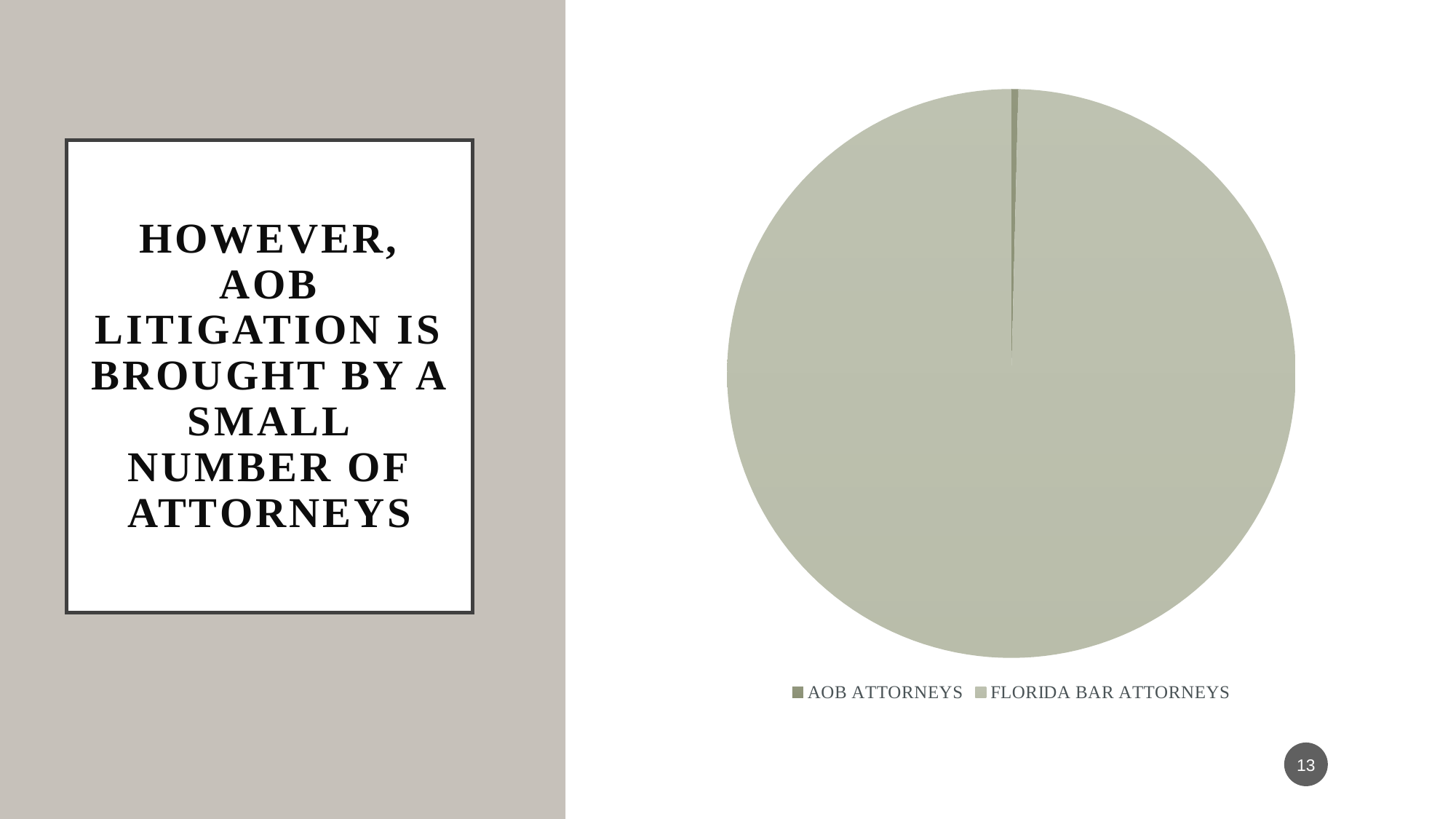
Which category takes up the smallest share of the pie chart? AOB Attorneys What are the two categories listed in the legend of the pie chart? AOB Attorneys and Florida Bar Attorneys How many entries does the legend of the pie chart list? 2 Which category takes up the largest share of the pie chart? Florida Bar Attorneys What kind of chart is shown on the slide? pie chart Which slice is larger in the pie chart, AOB Attorneys or Florida Bar Attorneys? Florida Bar Attorneys Which legend entry appears first in the pie chart's legend? AOB Attorneys How many slices does the pie chart have? 2